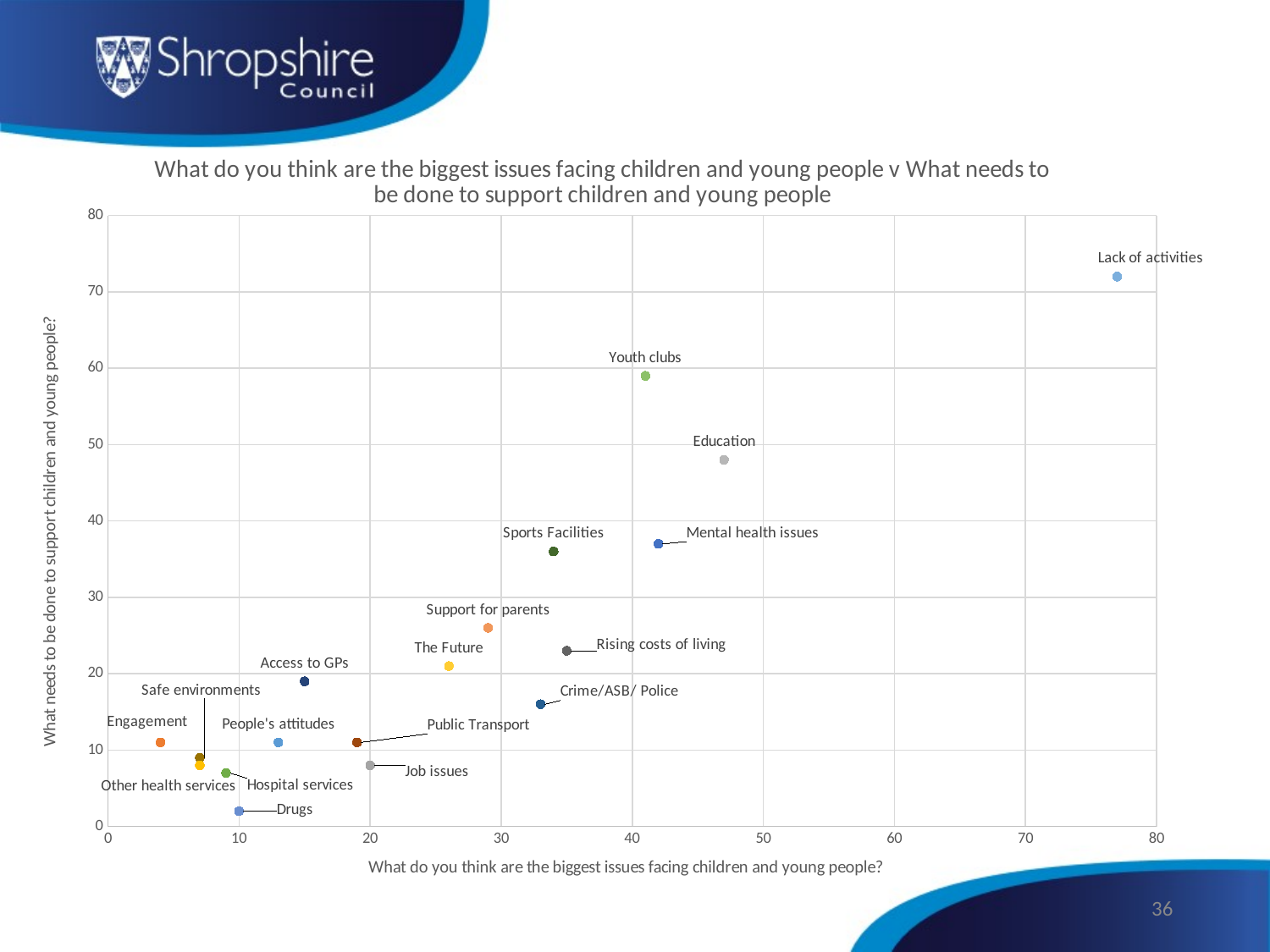
How many labelled data points are plotted on the chart? 18 Which point is furthest to the right on the horizontal axis (biggest issues facing children and young people)? Lack of activities Is the vertical-axis value for Drugs greater or less than 10? less Which has the higher vertical-axis value, Youth clubs or Education? Youth clubs What is the label of the horizontal axis? What do you think are the biggest issues facing children and young people? Is the vertical-axis value for Youth clubs greater or less than 50? greater Is the horizontal-axis value for Engagement greater or less than 10? less Which point has the lowest value on the vertical axis? Drugs Which point is further to the right on the horizontal axis, Mental health issues or Sports Facilities? Mental health issues What kind of chart is shown on the slide? Scatter chart Which point has the highest value on the vertical axis (What needs to be done to support children and young people)? Lack of activities